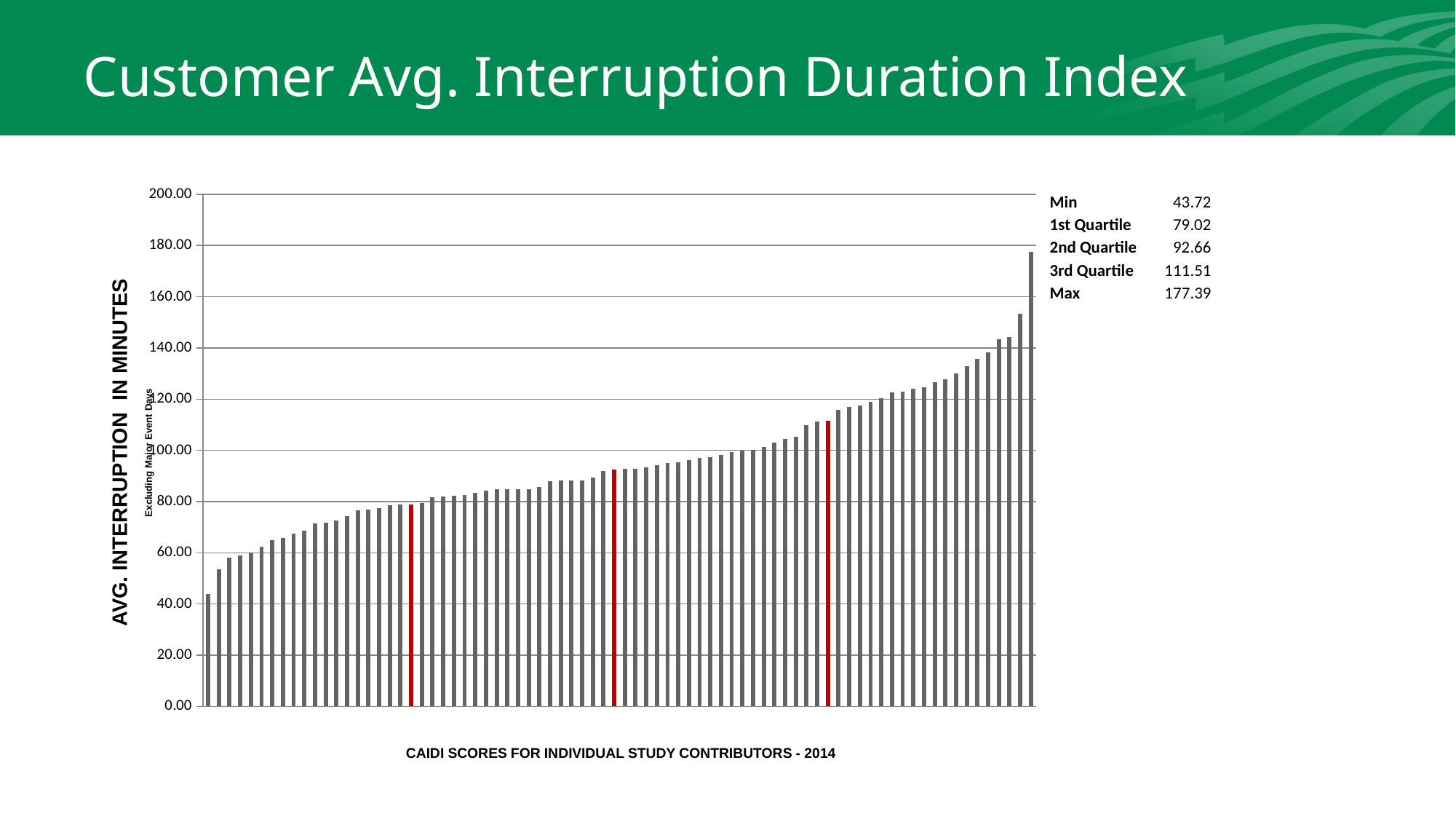
What is the 2nd Quartile value listed in the summary table? 92.66 Is the value of the rightmost red bar greater or less than 100? greater Is the value of the tallest bar greater or less than 160? greater What is the x-axis title of the chart? CAIDI SCORES FOR INDIVIDUAL STUDY CONTRIBUTORS - 2014 Do the bar values rise or fall from left to right along the x axis? rise Is the value of the shortest bar greater or less than 60? less What is the difference between the 3rd Quartile and 1st Quartile values shown in the summary table? 32.49 What kind of chart is shown on the slide? bar chart What is the 3rd Quartile value listed in the summary table? 111.51 What is the difference between the Max and Min values shown in the summary table? 133.67 What is the Max value listed in the summary table next to the chart? 177.39 What is the Min value listed in the summary table next to the chart? 43.72